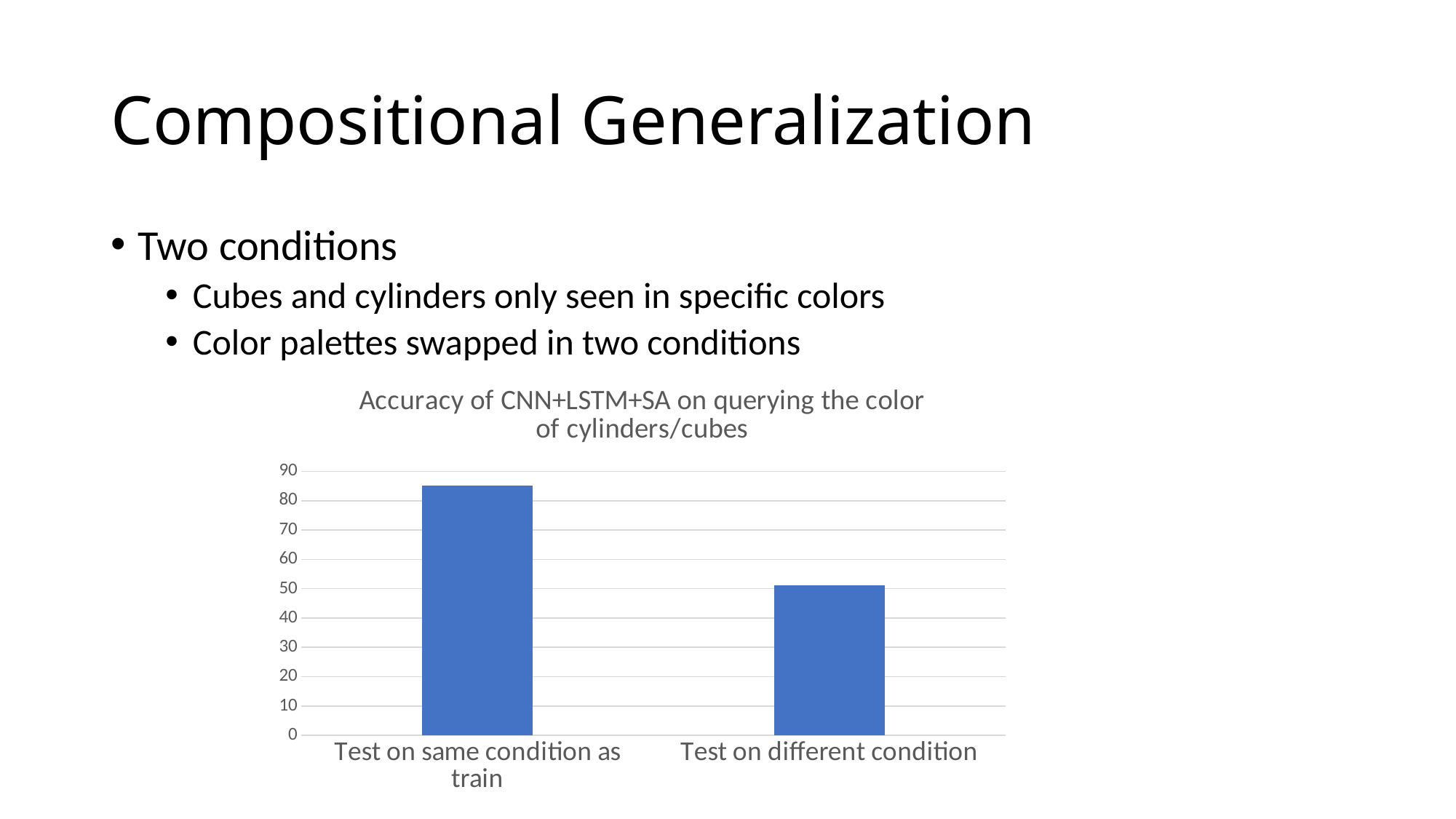
How many categories are plotted in the chart? 2 What kind of chart is shown on the slide? bar chart Which category has the highest value? Test on same condition as train What is the title of the chart? Accuracy of CNN+LSTM+SA on querying the color of cylinders/cubes Which category has the lowest value? Test on different condition Do the values rise or fall from left to right across the categories? fall Which is larger: the value for "Test on same condition as train" or the value for "Test on different condition"? Test on same condition as train Is the value for "Test on different condition" greater or less than 40? greater What is the highest value shown on the vertical axis? 90 Is the value for "Test on different condition" greater or less than 60? less Is the value for "Test on same condition as train" greater or less than 90? less